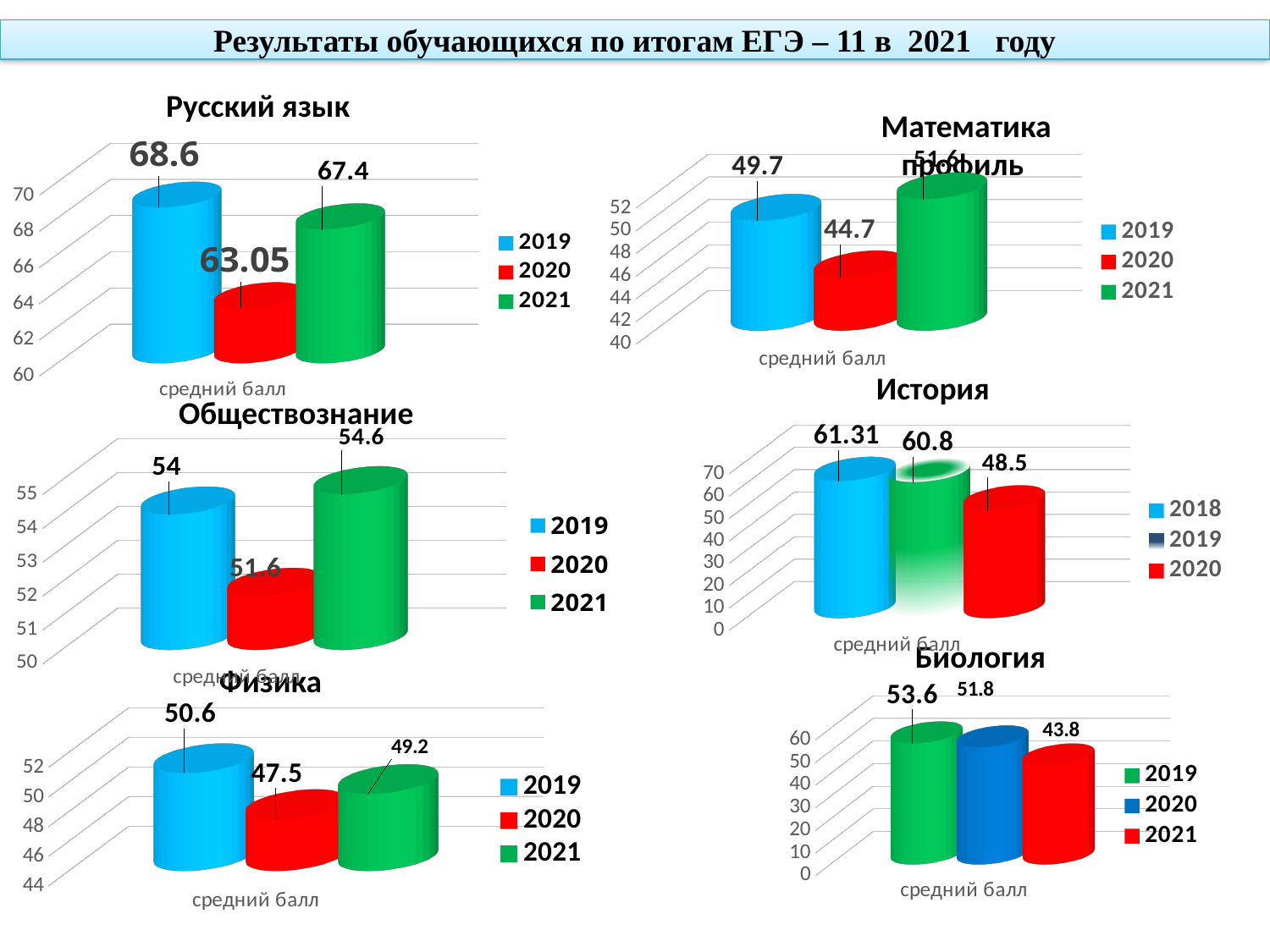
In the Русский язык chart, what is the value for 2019? 68.6 In the Русский язык chart, what is the value for 2020? 63.05 In the Математика профиль chart, what is the value for 2020? 44.7 In the Биология chart, what is the value for 2021? 43.8 In the Обществознание chart, what is the value for 2020? 51.6 In the История chart, which years does the legend list? 2018, 2019, 2020 In the Обществознание chart, which year has the highest value? 2021 In the История chart, what is the value for 2018? 61.31 What kind of chart is the Биология chart? bar chart In the Русский язык chart, which year has the lowest value? 2020 In the Физика chart, which is larger, the value for 2020 or the value for 2021? 2021 In the Математика профиль chart, what is the difference between the 2019 and 2020 values? 5